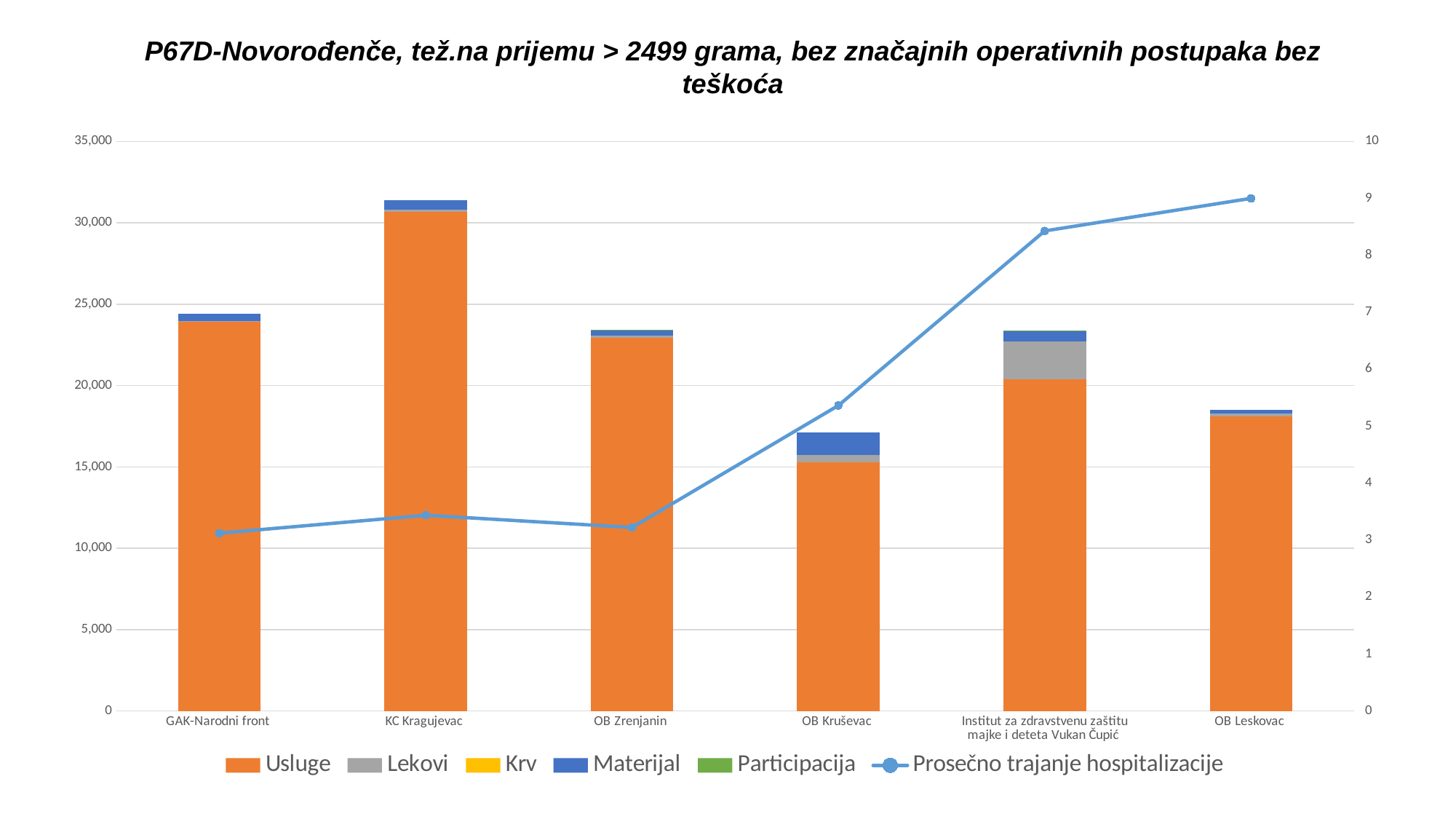
Is the Prosečno trajanje hospitalizacije value for OB Kruševac greater or less than 5? greater Which hospital has the shortest stacked bar? OB Kruševac How many series does the legend list? 6 Which hospital has the highest value on the Prosečno trajanje hospitalizacije line? OB Leskovac What kind of chart is shown on the slide? A stacked bar chart combined with a line chart Is the total stacked bar for OB Leskovac greater or less than 20,000? less Does the Prosečno trajanje hospitalizacije line generally rise or fall from left to right? rise Is the total stacked bar for KC Kragujevac greater or less than 30,000? greater How many hospitals (categories) are shown on the x axis? 6 Which hospital has the tallest stacked bar? KC Kragujevac Which has the taller stacked bar, KC Kragujevac or OB Leskovac? KC Kragujevac Which hospital has the lowest value on the Prosečno trajanje hospitalizacije line? GAK-Narodni front